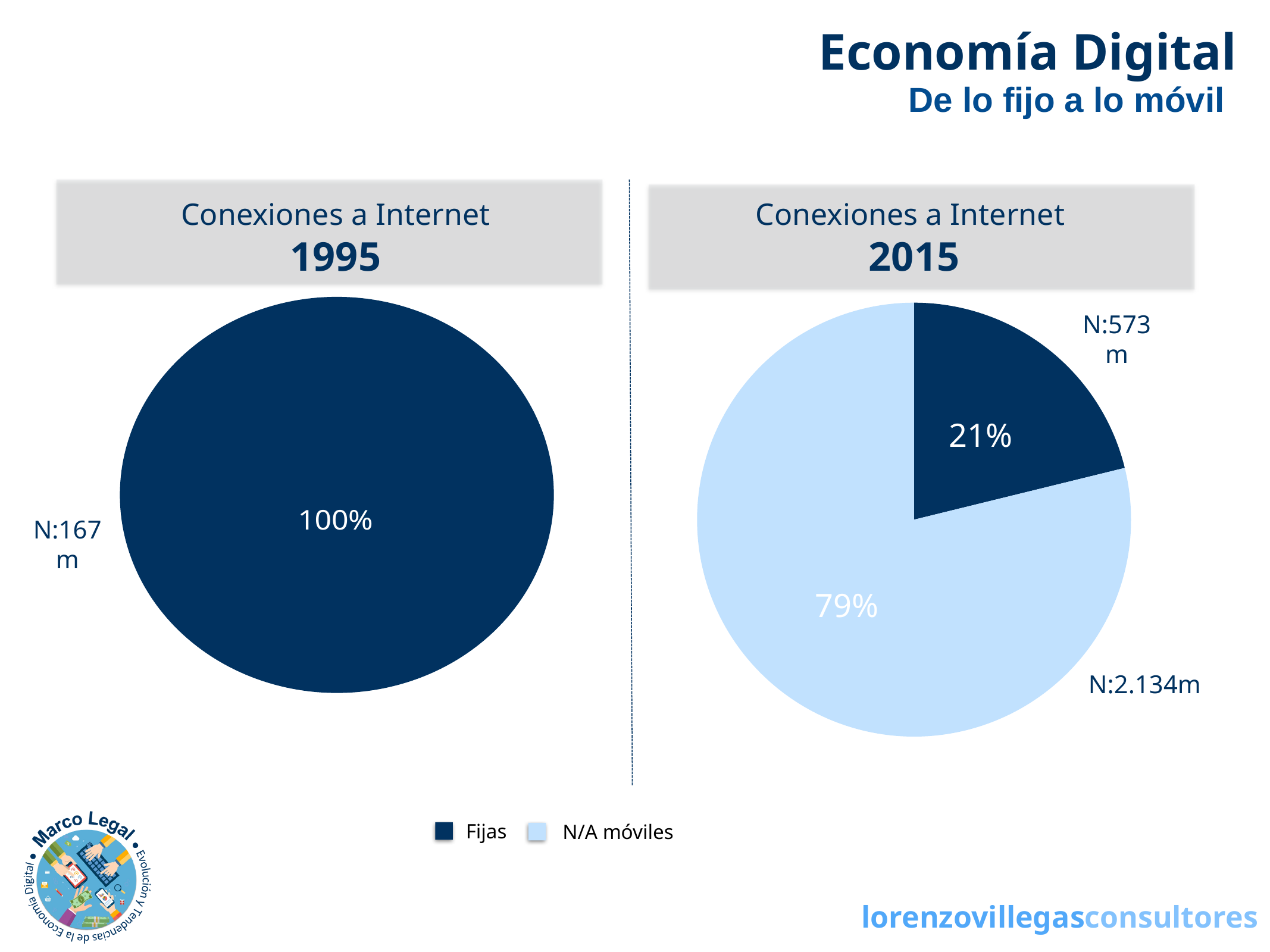
In the 'Conexiones a Internet 2015' chart, what percentage share does the N/A móviles slice have? 79% In the 'Conexiones a Internet 1995' chart, what percentage share does the Fijas slice have? 100% In the 'Conexiones a Internet 2015' chart, which category has the smallest slice? Fijas In the 'Conexiones a Internet 1995' chart, what N value is labelled next to the pie? N:167 m In the 'Conexiones a Internet 2015' chart, which slice is larger, Fijas or N/A móviles? N/A móviles In the 'Conexiones a Internet 2015' chart, what percentage share does the Fijas slice have? 21% How many series does the legend list? 2 In the 'Conexiones a Internet 2015' chart, what N value is labelled next to the Fijas slice? N:573 m In the 'Conexiones a Internet 2015' chart, which category has the largest slice? N/A móviles In the 'Conexiones a Internet 2015' chart, what N value is labelled next to the N/A móviles slice? N:2.134m What kind of chart is the 'Conexiones a Internet 1995' chart? Pie chart In the 'Conexiones a Internet 2015' chart, what is the difference in percentage points between the N/A móviles slice and the Fijas slice? 58